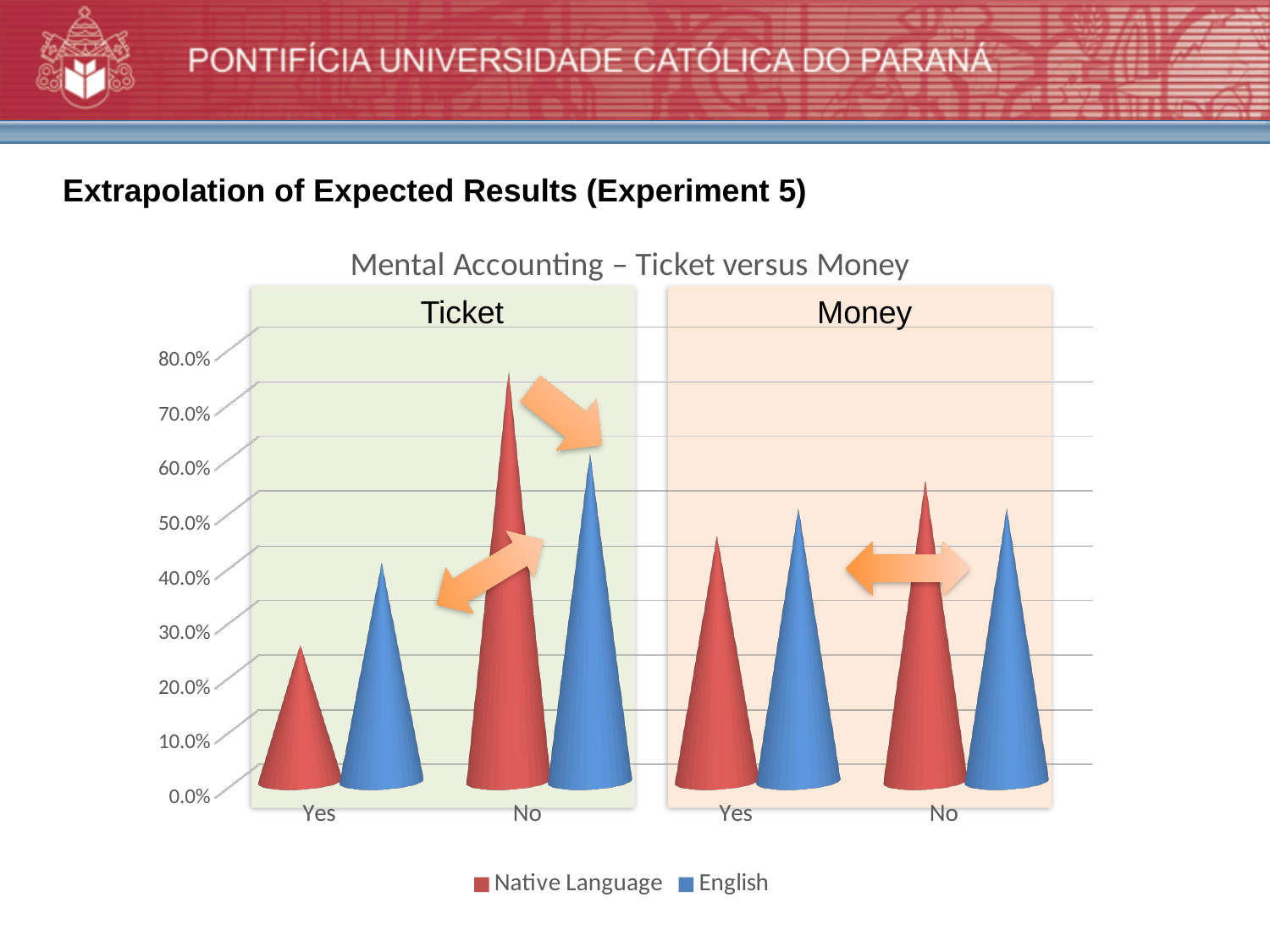
How many series does the legend list? 2 In the Ticket group, for the No category, which is larger: Native Language or English? Native Language What kind of chart is this? bar chart Which category and series has the lowest value in the chart? Native Language, Ticket Yes What is the title of the chart? Mental Accounting – Ticket versus Money Is the English value for Ticket Yes greater or less than 50.0%? less In the Ticket group, for the Yes category, which is larger: Native Language or English? English Which category and series has the highest value in the chart? Native Language, Ticket No Is the Native Language value for Ticket Yes greater or less than 30.0%? less Is the Native Language value for Money Yes greater or less than 30.0%? greater Which series is shown in red? Native Language